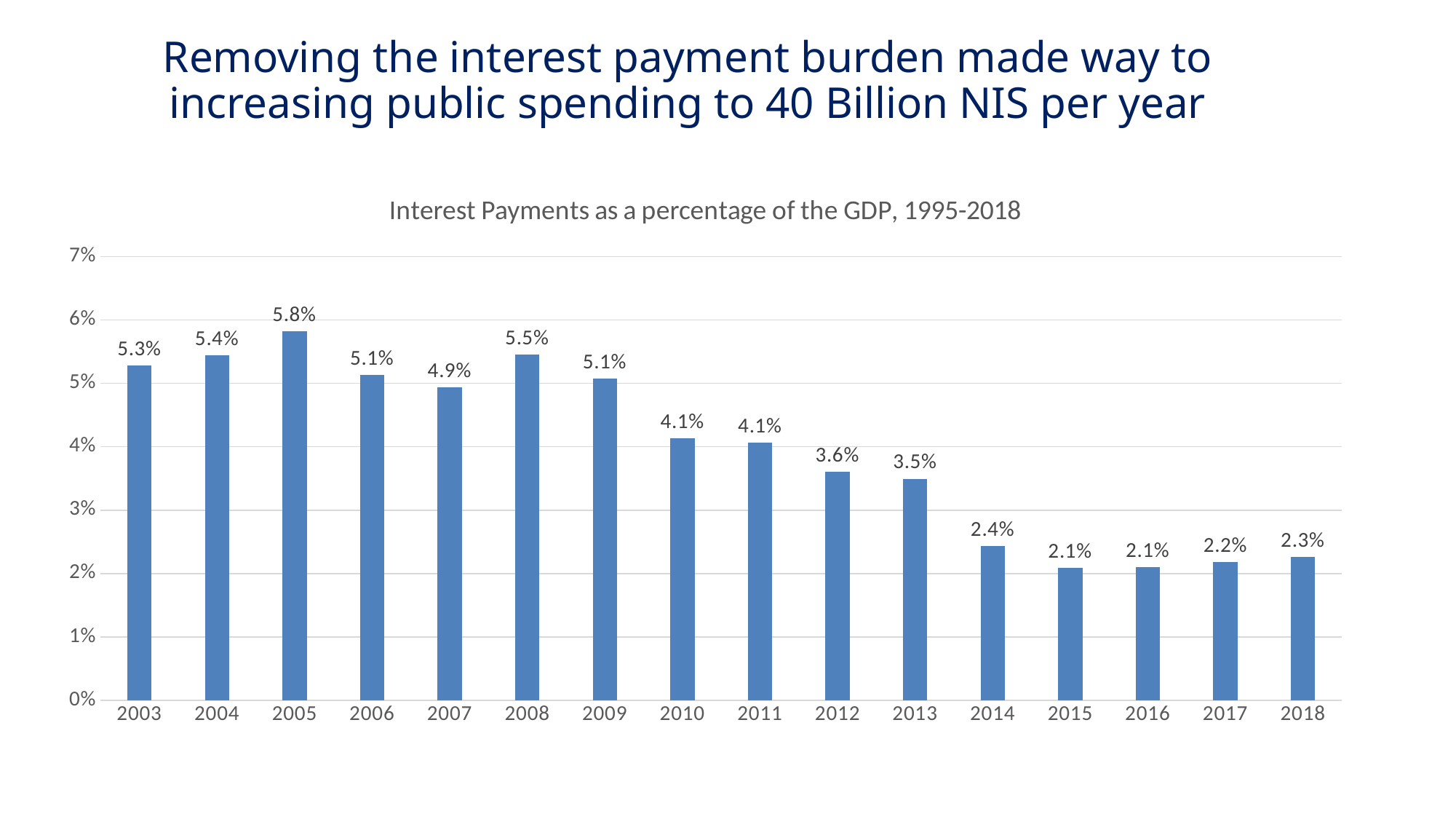
Which is larger, the value for 2008 or the value for 2009? 2008 What is the value shown for 2014? 2.4% What is the difference between the values for 2005 and 2018? 3.5% Which year has the highest interest payment as a percentage of GDP? 2005 How many years are shown on the x axis? 16 What is the title of the chart? Interest Payments as a percentage of the GDP, 1995-2018 Do the values generally rise or fall from 2003 to 2018? fall Is the value for 2012 greater or less than 4%? less What kind of chart is shown on the slide? bar chart What is the interest payment as a percentage of GDP for 2005? 5.8% What is the difference between the values for 2013 and 2014? 1.1% What is the value shown for 2010? 4.1%